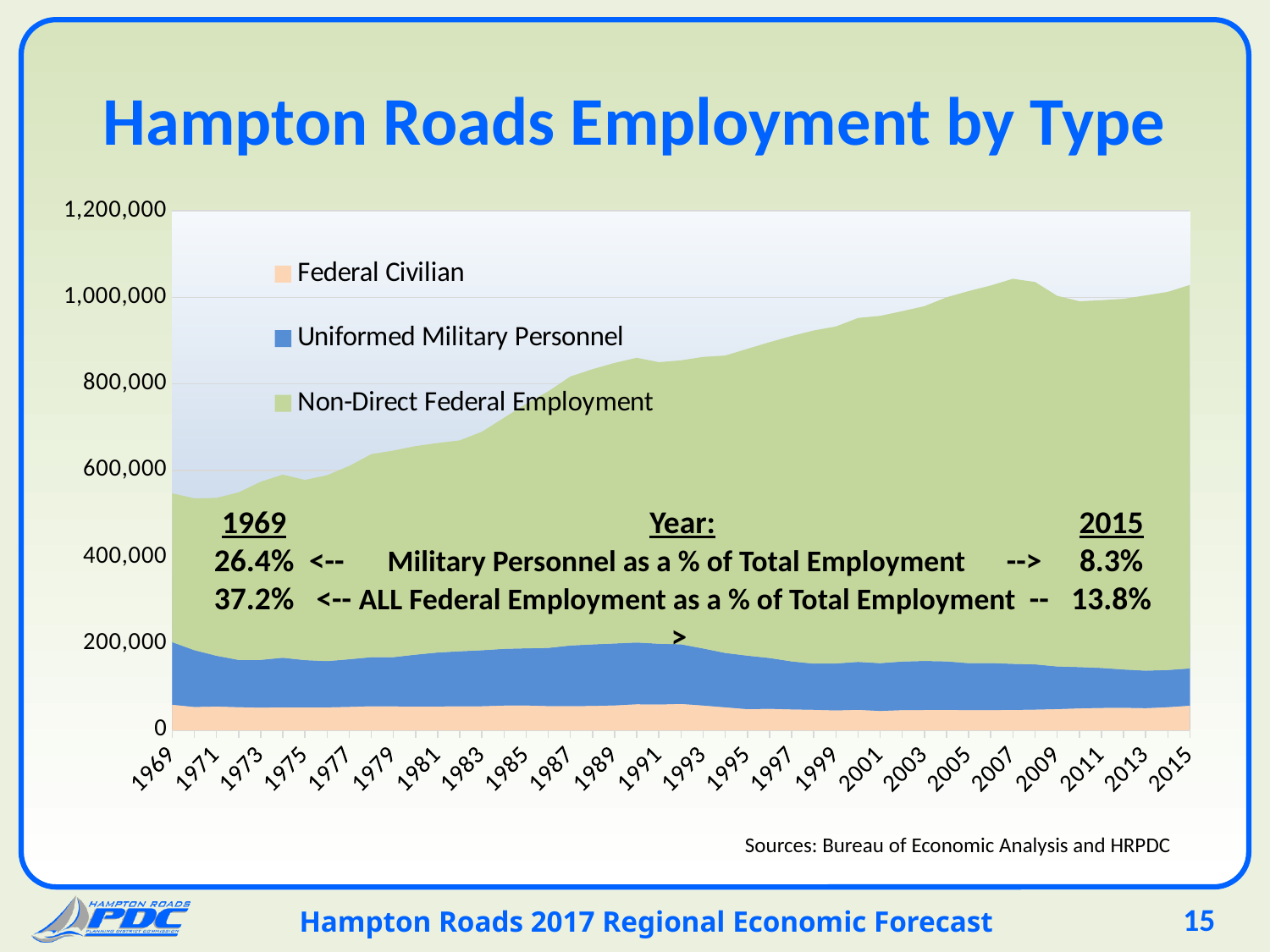
According to the annotation, what was ALL Federal Employment as a % of Total Employment in 2015? 13.8% What kind of chart is shown on the slide? Stacked area chart Does total employment generally rise or fall from 1969 to 2015? Rise What is the title of the chart? Hampton Roads Employment by Type How many series does the legend list? 3 Is Uniformed Military Personnel employment larger in 1991 or in 2015? 1991 Is total employment in 2015 greater or less than 1,000,000? greater Is total employment in 1969 greater or less than 600,000? less Which series is shown in green? Non-Direct Federal Employment According to the annotation, what was Military Personnel as a % of Total Employment in 2015? 8.3% According to the annotation, what was ALL Federal Employment as a % of Total Employment in 1969? 37.2% According to the annotation, what was Military Personnel as a % of Total Employment in 1969? 26.4%